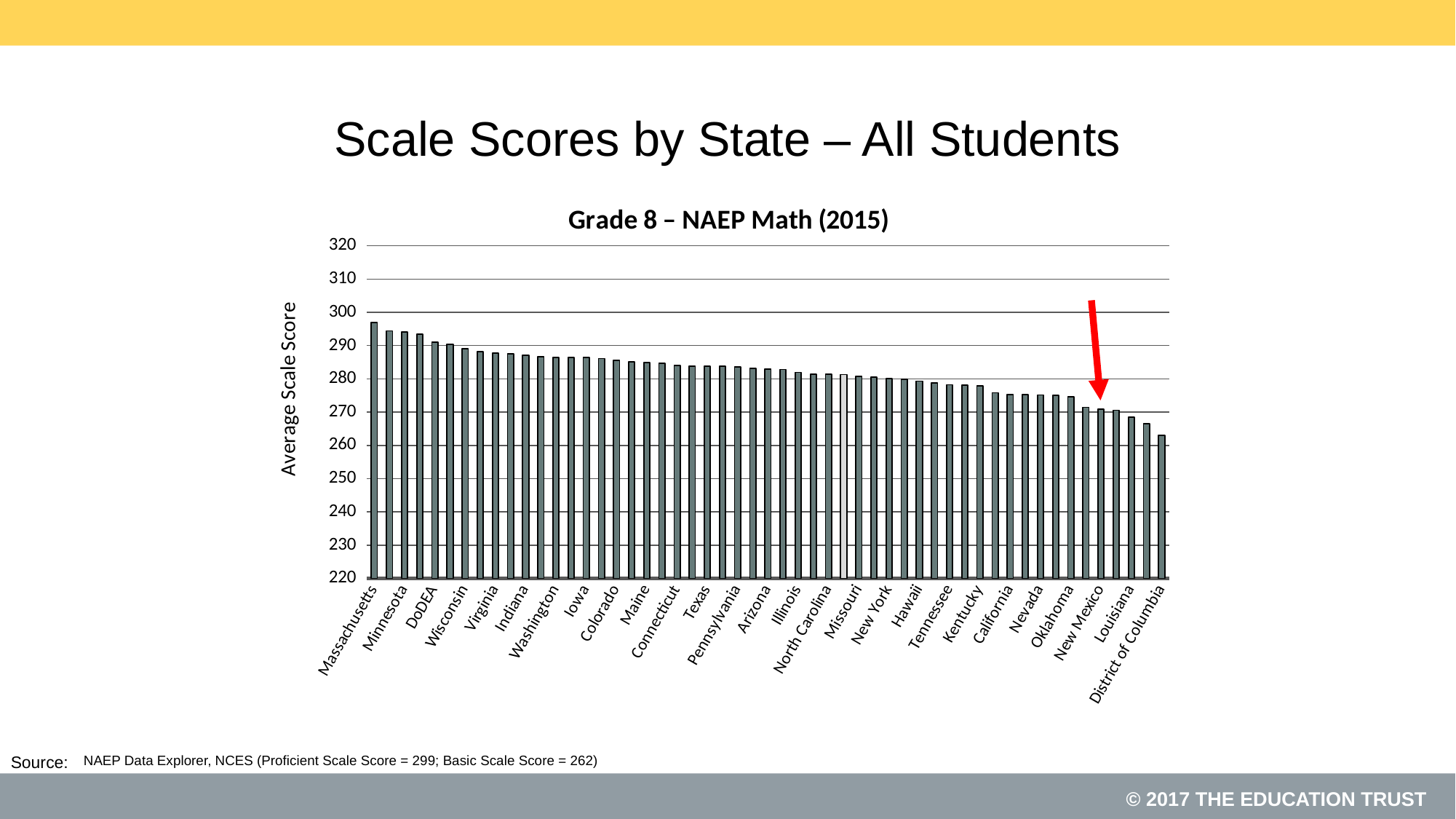
Is the value for District of Columbia greater or less than 270? less Which has the larger average scale score, Wisconsin or Nevada? Wisconsin Is the value for New Mexico greater or less than 280? less Which state has the highest average scale score in the chart? Massachusetts Which has the larger average scale score, Minnesota or New Mexico? Minnesota Is the value for Texas greater or less than 280? greater What kind of chart is shown on the slide? Bar chart Which jurisdiction has the lowest average scale score in the chart? District of Columbia What is the title of the chart? Grade 8 – NAEP Math (2015) Do the average scale scores rise or fall moving from left to right along the x axis? Fall